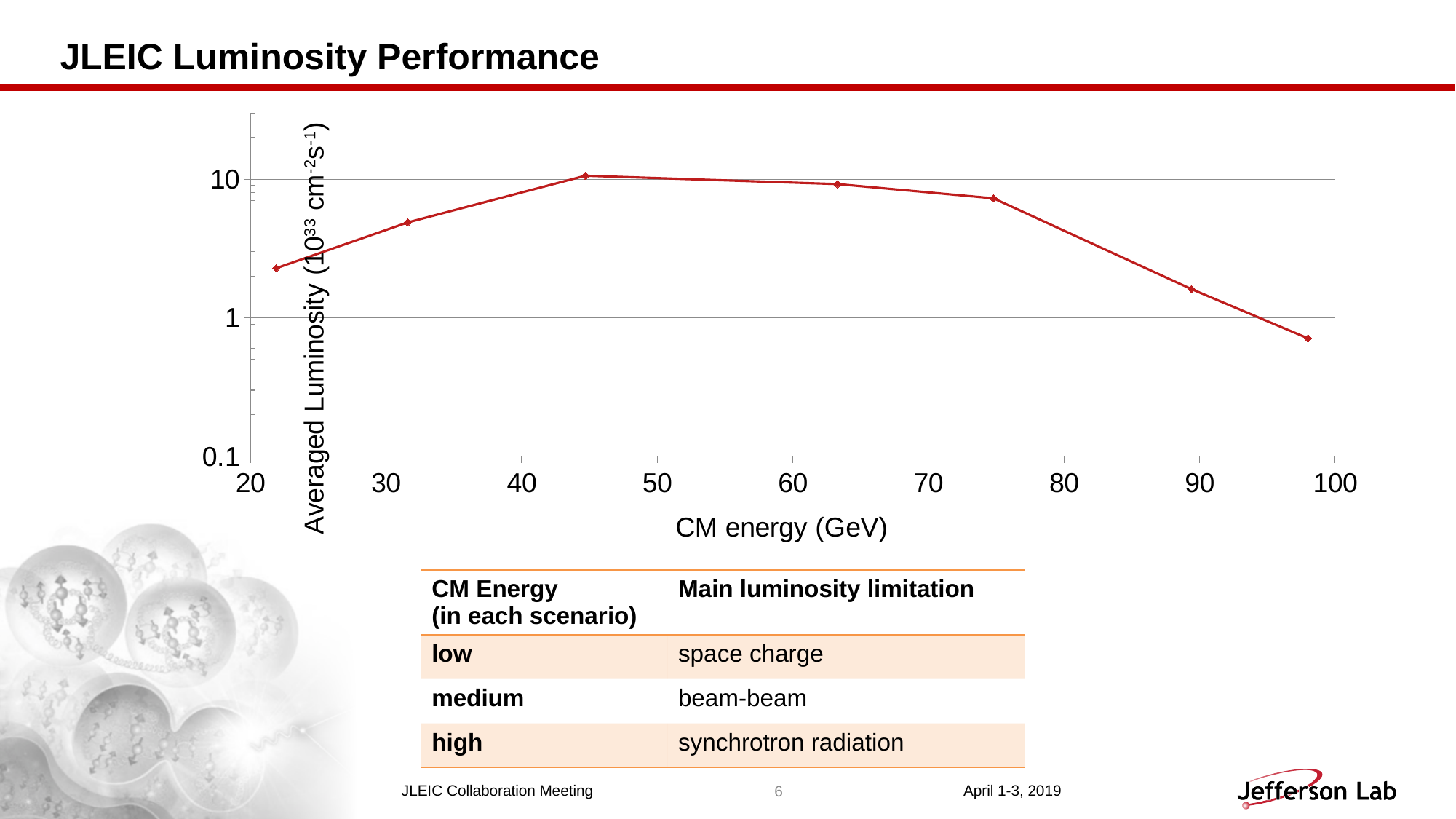
Is the averaged luminosity at the lowest CM energy (near 20 GeV) greater or less than 1? greater Is the averaged luminosity at a CM energy of about 90 GeV greater or less than 1? greater What kind of chart is shown on the slide? line chart How many data points are plotted on the line? 7 Is the averaged luminosity at the highest CM energy (near 100 GeV) greater or less than 1? less What is the label of the x axis? CM energy (GeV) How does the averaged luminosity change as CM energy increases from about 45 GeV to 100 GeV? it falls What is the label of the y axis? Averaged Luminosity (10^33 cm^-2 s^-1)